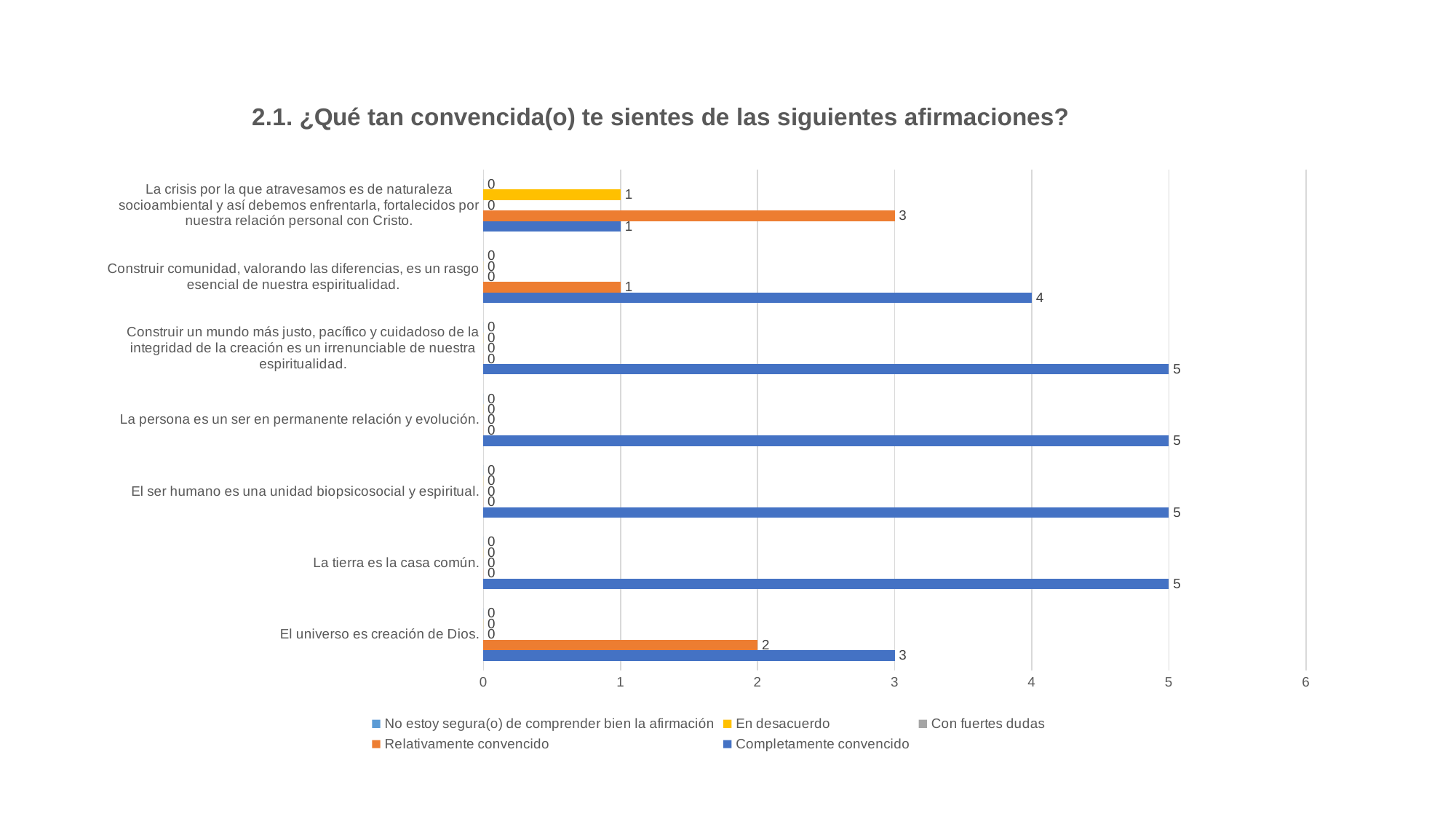
What kind of chart is shown on the slide? bar chart What is the difference between the 'Completamente convencido' values for 'Construir comunidad, valorando las diferencias, es un rasgo esencial de nuestra espiritualidad.' and 'El universo es creación de Dios.'? 1 What is the value of 'En desacuerdo' for 'La crisis por la que atravesamos es de naturaleza socioambiental y así debemos enfrentarla, fortalecidos por nuestra relación personal con Cristo.'? 1 How many statements (categories) are plotted on the chart? 7 How many series does the legend list? 5 What is the value of 'Relativamente convencido' for 'El universo es creación de Dios.'? 2 What is the value of 'Relativamente convencido' for 'La crisis por la que atravesamos es de naturaleza socioambiental y así debemos enfrentarla, fortalecidos por nuestra relación personal con Cristo.'? 3 What is the value of 'Completamente convencido' for 'El universo es creación de Dios.'? 3 Which statement has the lowest value for 'Completamente convencido'? La crisis por la que atravesamos es de naturaleza socioambiental y así debemos enfrentarla, fortalecidos por nuestra relación personal con Cristo. What is the value of 'Completamente convencido' for 'La tierra es la casa común.'? 5 For 'El universo es creación de Dios.', which is larger: 'Relativamente convencido' or 'Completamente convencido'? Completamente convencido What is the value of 'Completamente convencido' for 'Construir comunidad, valorando las diferencias, es un rasgo esencial de nuestra espiritualidad.'? 4